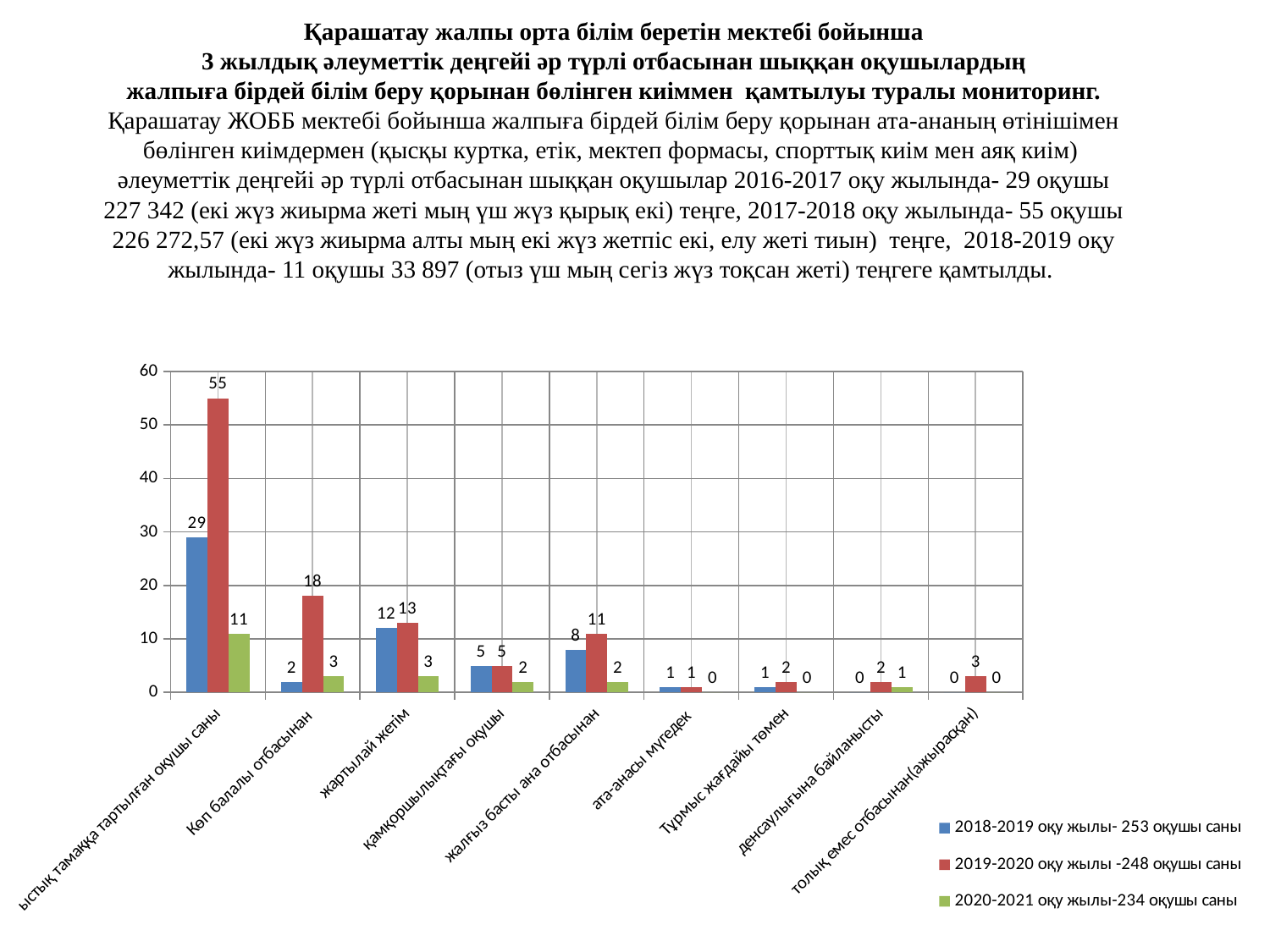
Is the 2018-2019 value for 'ыстық тамаққа тартылған оқушы саны' greater or less than 20? greater Which category has the highest value in the 2019-2020 оқу жылы series? ыстық тамаққа тартылған оқушы саны How many categories are shown on the x axis? 9 What is the value for 'ыстық тамаққа тартылған оқушы саны' in the 2019-2020 оқу жылы series? 55 Which is larger for 'жалғыз басты ана отбасынан': the 2018-2019 value or the 2019-2020 value? 2019-2020 What is the value for 'Көп балалы отбасынан' in the 2018-2019 оқу жылы series? 2 What is the value for 'жартылай жетім' in the 2020-2021 оқу жылы series? 3 What is the value for 'толық емес отбасынан(ажырасқан)' in the 2019-2020 оқу жылы series? 3 Which colour represents the 2020-2021 оқу жылы series? green How many series does the legend list? 3 What is the difference between the 2019-2020 and 2018-2019 values for 'ыстық тамаққа тартылған оқушы саны'? 26 What type of chart is shown on the slide? bar chart